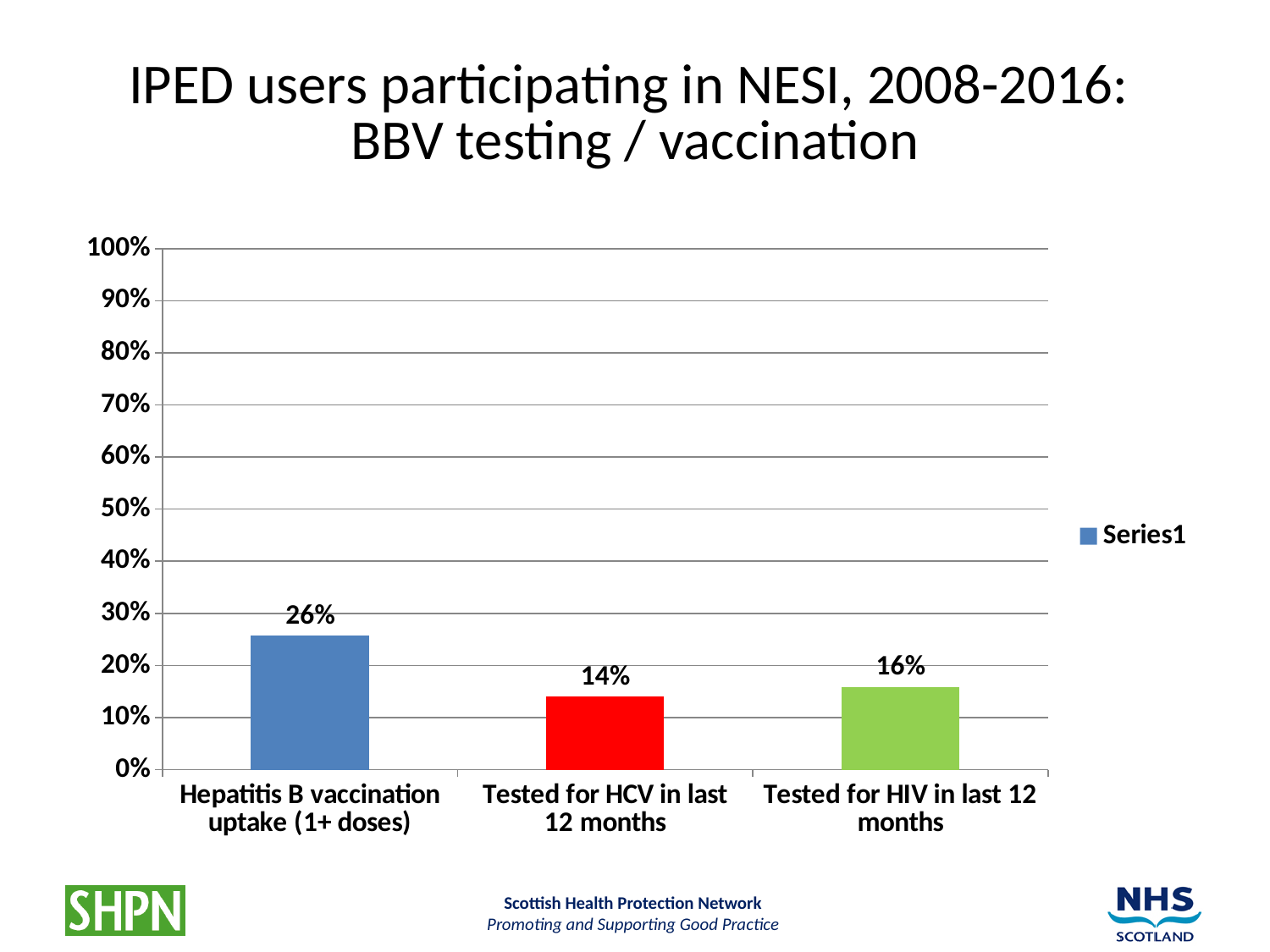
What is the value for Hepatitis B vaccination uptake (1+ doses)? 26% What is the difference between the value for Tested for HIV in last 12 months and the value for Tested for HCV in last 12 months? 2% Is the value for Hepatitis B vaccination uptake (1+ doses) greater or less than 30%? less What is the title of the chart? IPED users participating in NESI, 2008-2016: BBV testing / vaccination Which category has the lowest value? Tested for HCV in last 12 months What is the value for Tested for HIV in last 12 months? 16% Which is larger: the value for Tested for HCV in last 12 months or the value for Tested for HIV in last 12 months? Tested for HIV in last 12 months How many categories are shown on the chart? 3 What is the difference between the value for Hepatitis B vaccination uptake (1+ doses) and the value for Tested for HIV in last 12 months? 10% Which category has the highest value? Hepatitis B vaccination uptake (1+ doses) What is the value for Tested for HCV in last 12 months? 14% What kind of chart is shown on the slide? bar chart